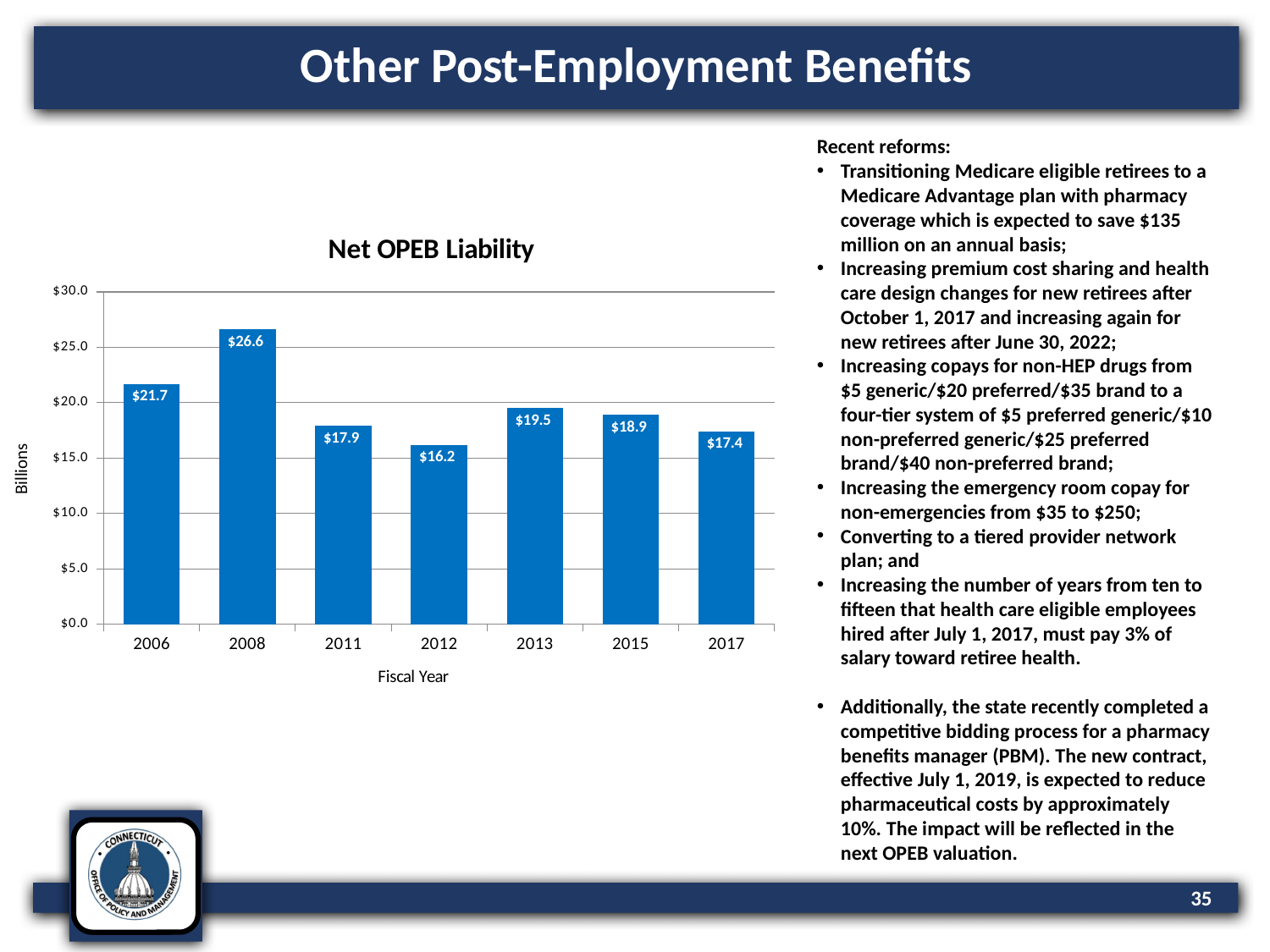
Which is larger, the Net OPEB Liability in 2011 or in 2017? 2011 Which fiscal year has the highest Net OPEB Liability? 2008 What is the Net OPEB Liability for fiscal year 2017? $17.4 What is the difference between the Net OPEB Liability in 2008 and in 2006? $4.9 What kind of chart is used to show the Net OPEB Liability? bar chart How many fiscal years are shown in the Net OPEB Liability chart? 7 What is the Net OPEB Liability for fiscal year 2012? $16.2 Which fiscal year has the lowest Net OPEB Liability? 2012 What is the label on the vertical axis of the Net OPEB Liability chart? Billions What is the Net OPEB Liability for fiscal year 2008? $26.6 Is the Net OPEB Liability for 2006 greater or less than $20.0? greater What is the difference between the Net OPEB Liability in 2013 and in 2015? $0.6